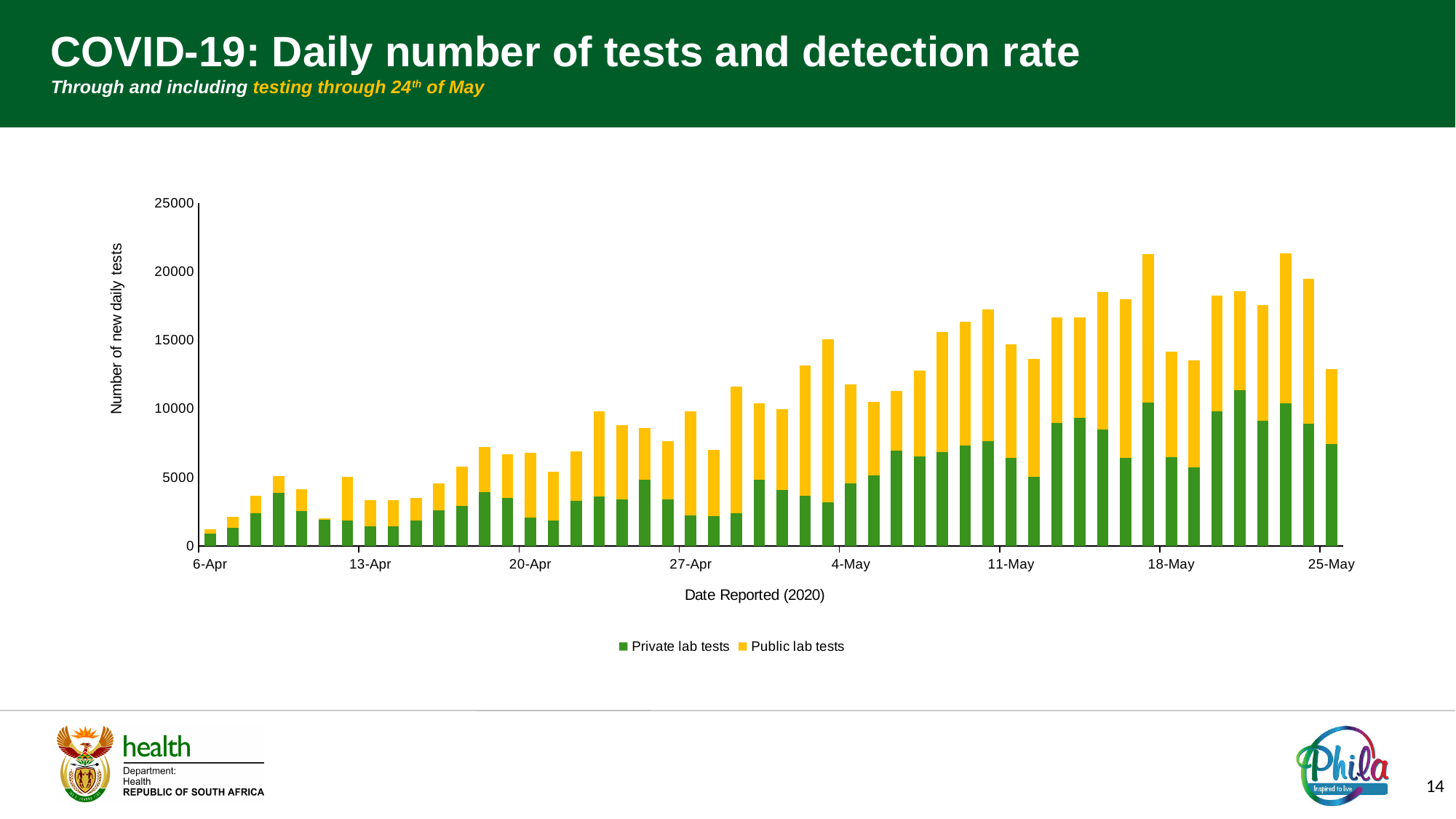
How many series does the legend list? 2 Is the total number of tests on 6-Apr greater or less than 5000? less Is the total number of tests on 13-Apr greater or less than 5000? less Which date has a larger total number of tests, 13-Apr or 20-Apr? 20-Apr Which date has the lowest total number of daily tests? 6-Apr What kind of chart is shown on the slide? Stacked bar chart Is the total number of tests on 20-Apr greater or less than 5000? greater Do the total daily tests generally rise or fall from 6-Apr to 25-May? Rise What are the two series named in the legend? Private lab tests and Public lab tests What is the label of the y axis? Number of new daily tests